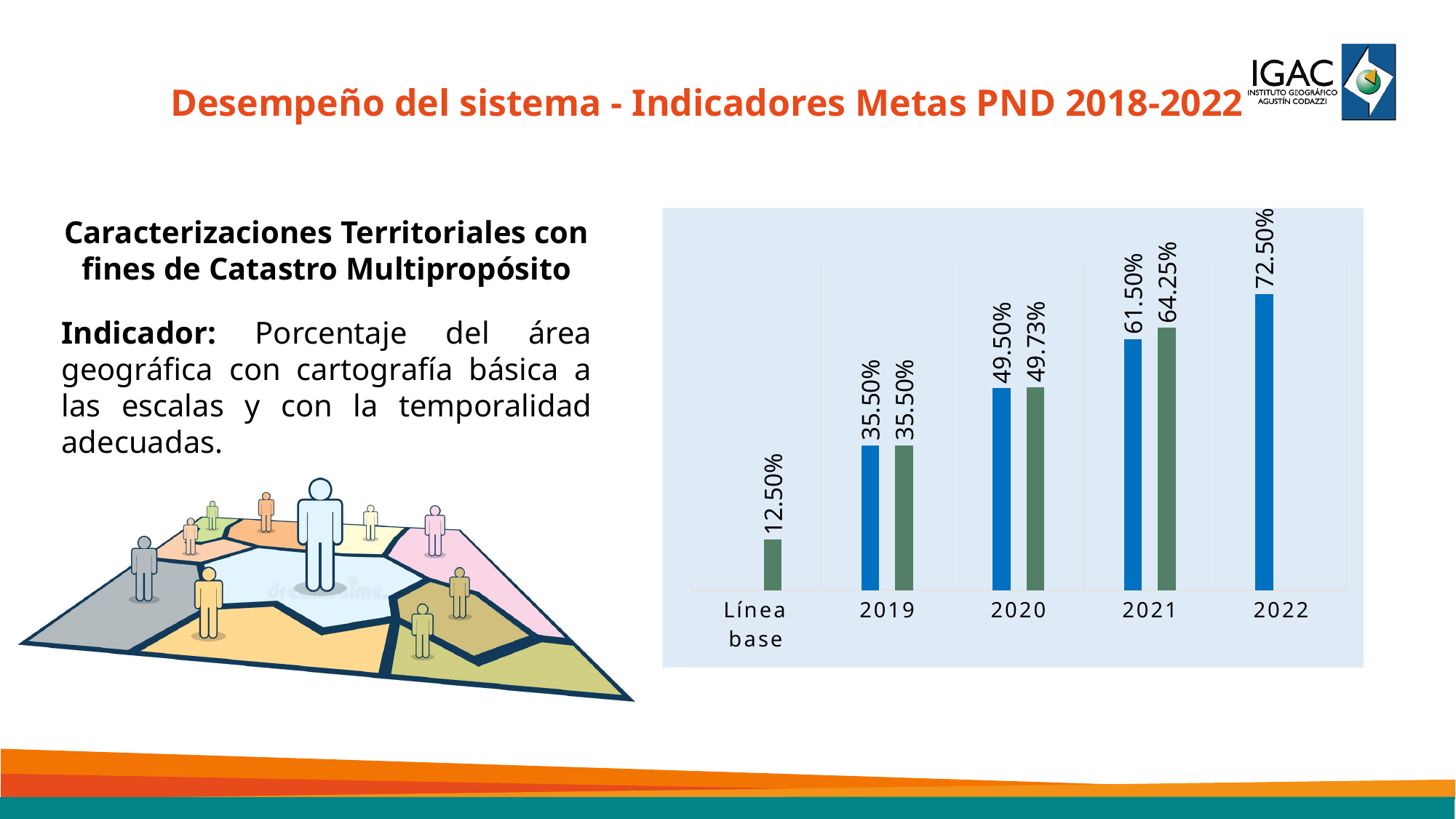
Which category has the lowest value in the chart? Línea base What is the value of the blue bar for 2022? 72.50% Do the blue bar values rise or fall from 2019 to 2022? rise What is the value of the green bar for 2021? 64.25% How many categories are shown on the x axis of the chart? 5 What type of chart is shown on the slide? bar chart Which category has the highest value in the chart? 2022 Which is larger for 2021, the blue bar or the green bar? the green bar What is the difference between the green bar and the blue bar for 2021? 2.75% What is the value of the blue bar for 2020? 49.50% What is the value of the green bar for 2019? 35.50% What is the value of the green bar for Línea base? 12.50%